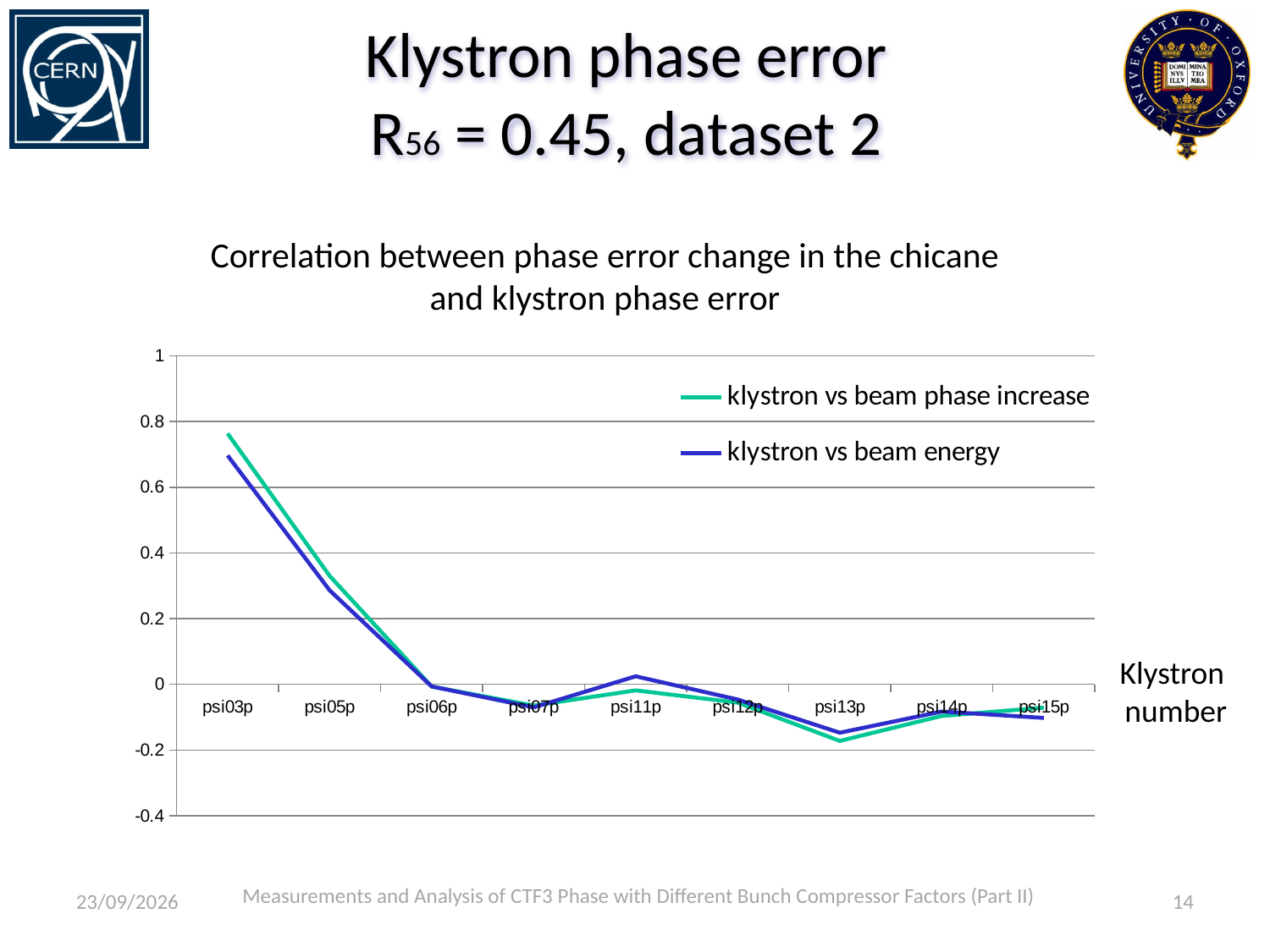
Is the 'klystron vs beam energy' value for psi05p greater or less than 0.2? greater Do the values rise or fall from psi03p to psi06p? fall Which klystron has the highest value for the 'klystron vs beam phase increase' series? psi03p How many klystron categories are plotted along the x axis? 9 Which klystron has the highest value for the 'klystron vs beam energy' series? psi03p Which klystron has the lowest value for the 'klystron vs beam phase increase' series? psi13p Is the 'klystron vs beam phase increase' value for psi13p greater or less than 0? less At psi03p, which series has the larger value, 'klystron vs beam phase increase' or 'klystron vs beam energy'? klystron vs beam phase increase How many series does the legend list? 2 What label is given to the x axis of the chart? Klystron number Is the 'klystron vs beam phase increase' value for psi03p greater or less than 0.6? greater What kind of chart is shown on the slide? line chart